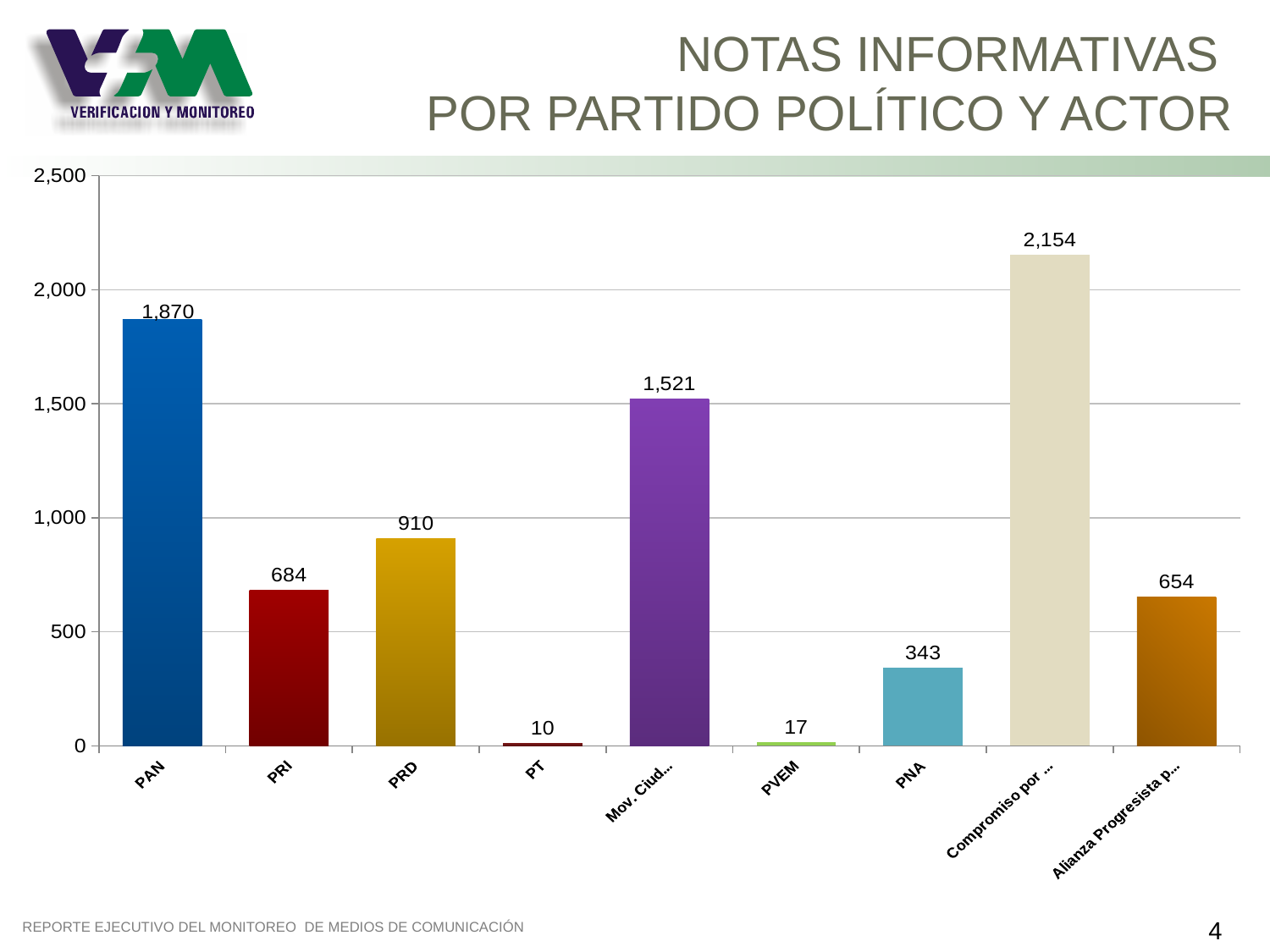
Which is larger, the value for PRI or the value for PNA? PRI How many categories are shown on the x axis of the chart? 9 What is the value shown for PRD? 910 What is the value shown for PNA? 343 What is the value shown for PVEM? 17 How many notas informativas does the chart show for PAN? 1,870 Which category has the highest value in the chart? Compromiso por ... What kind of chart is shown on the slide? Bar chart What is the difference between the values for PRD and Alianza Progresista p...? 256 What is the difference between the values for PAN and PRI? 1,186 What is the title of the slide containing the chart? NOTAS INFORMATIVAS POR PARTIDO POLÍTICO Y ACTOR Which category has the lowest value in the chart? PT